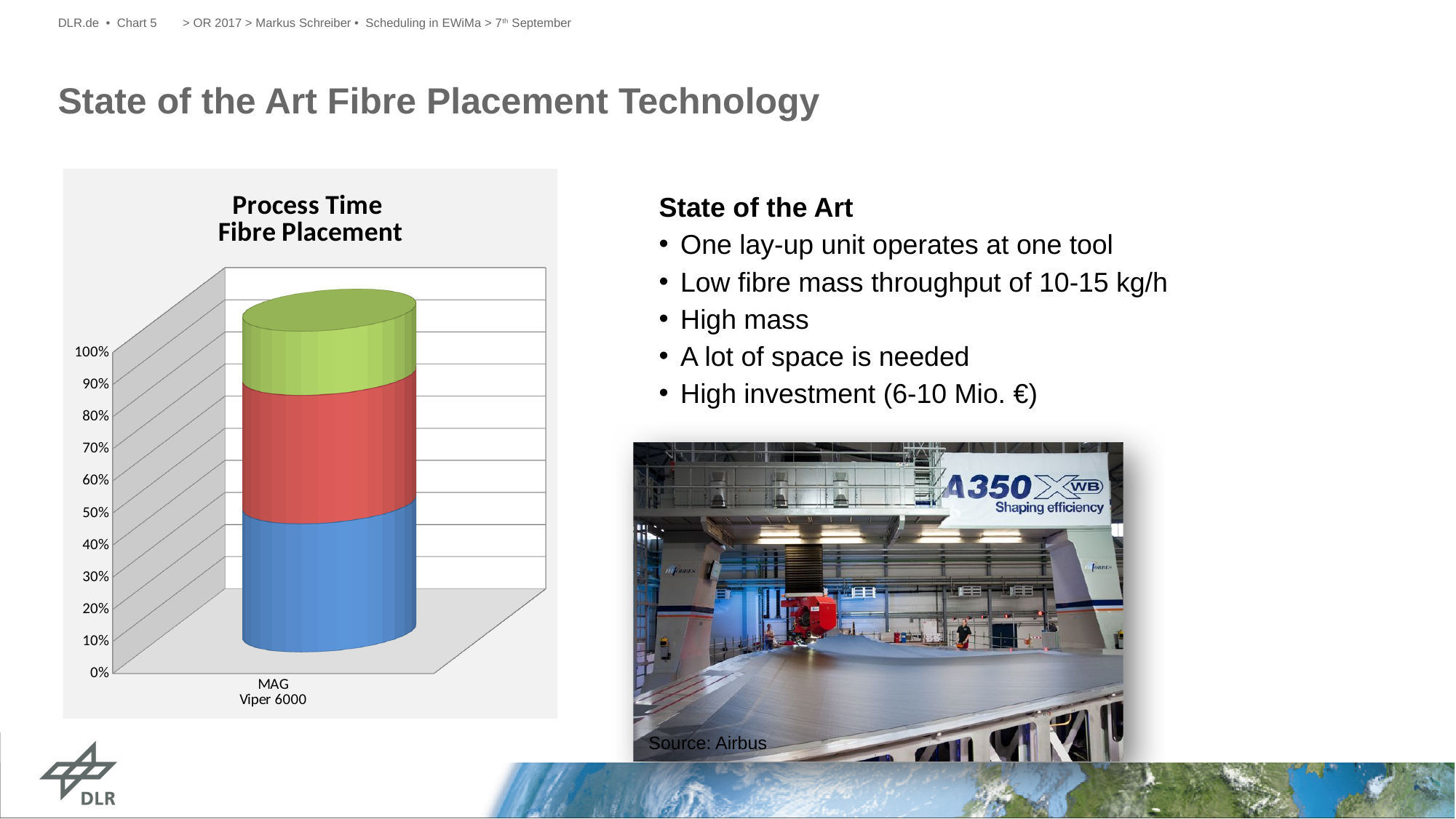
Is the total height of the stacked bar for MAG Viper 6000 greater or less than 80%? greater What kind of chart is shown on the slide? Stacked bar chart How many categories are plotted on the x axis of the chart? 1 How many stacked segments make up the bar for MAG Viper 6000? 3 What is the title of the chart on the slide? Process Time Fibre Placement What colour is the bottom segment of the stacked bar for MAG Viper 6000? Blue What is the label of the single category on the x axis of the chart? MAG Viper 6000 What is the highest value shown on the vertical axis of the chart? 100% Is the value of the blue (bottom) segment for MAG Viper 6000 greater or less than 20%? greater